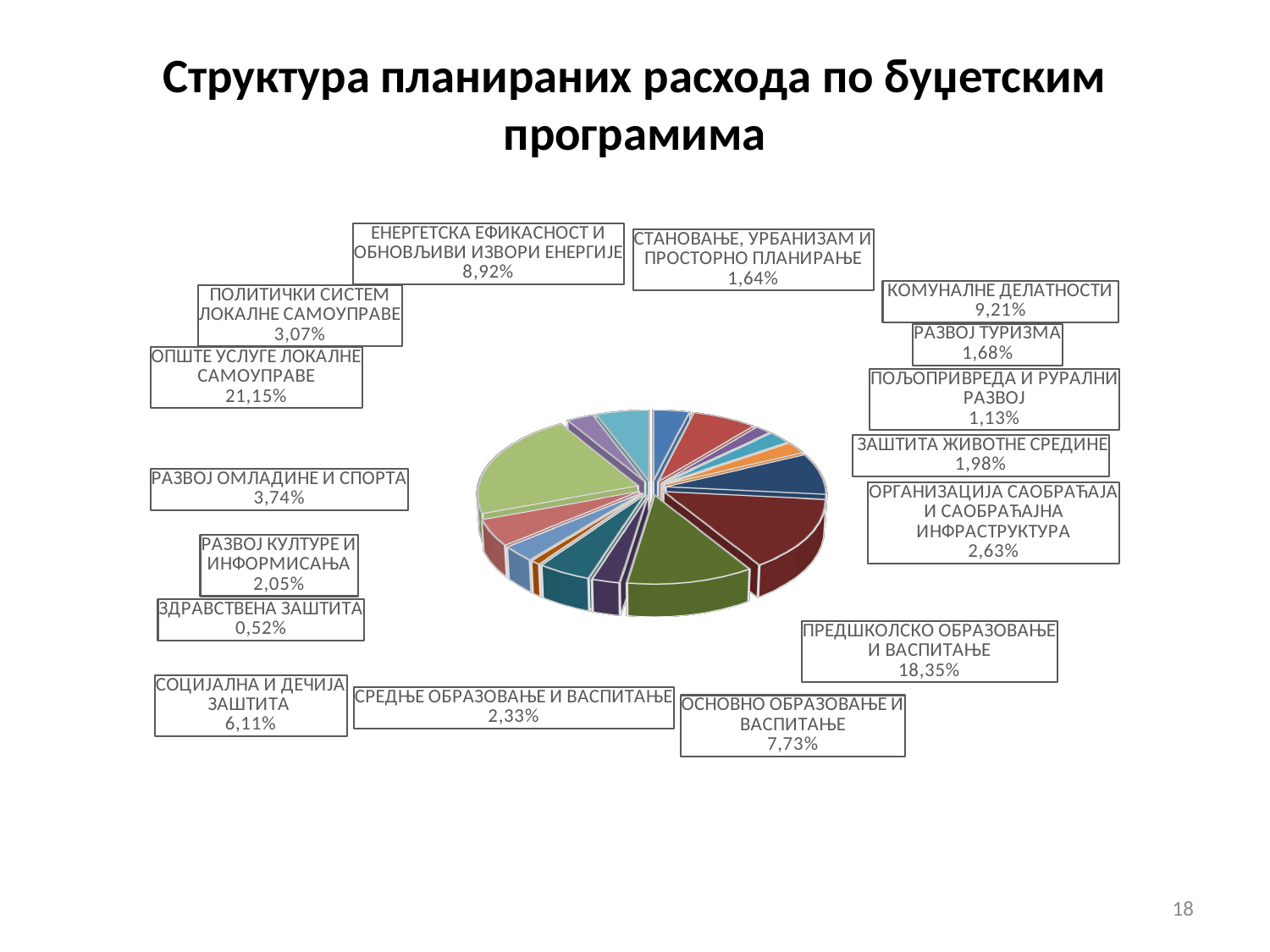
What is the difference in percentage points between ОСНОВНО ОБРАЗОВАЊЕ И ВАСПИТАЊЕ and СОЦИЈАЛНА И ДЕЧИЈА ЗАШТИТА? 1,62% Which category has the largest share in the pie chart? ОПШТЕ УСЛУГЕ ЛОКАЛНЕ САМОУПРАВЕ What share does ПОЉОПРИВРЕДА И РУРАЛНИ РАЗВОЈ have in the pie chart? 1,13% How many categories (slices) are labelled in the pie chart? 16 Which has a larger share: ЕНЕРГЕТСКА ЕФИКАСНОСТ И ОБНОВЉИВИ ИЗВОРИ ЕНЕРГИЈЕ or ОСНОВНО ОБРАЗОВАЊЕ И ВАСПИТАЊЕ? ЕНЕРГЕТСКА ЕФИКАСНОСТ И ОБНОВЉИВИ ИЗВОРИ ЕНЕРГИЈЕ What share does СОЦИЈАЛНА И ДЕЧИЈА ЗАШТИТА have in the pie chart? 6,11% What type of chart is shown on the slide? pie chart What is the title of the chart on the slide? Структура планираних расхода по буџетским програмима What is the difference in percentage points between ОПШТЕ УСЛУГЕ ЛОКАЛНЕ САМОУПРАВЕ and ПРЕДШКОЛСКО ОБРАЗОВАЊЕ И ВАСПИТАЊЕ? 2,80% Which category has the smallest share in the pie chart? ЗДРАВСТВЕНА ЗАШТИТА What share does КОМУНАЛНЕ ДЕЛАТНОСТИ have in the pie chart? 9,21% What share does ПРЕДШКОЛСКО ОБРАЗОВАЊЕ И ВАСПИТАЊЕ have in the pie chart? 18,35%